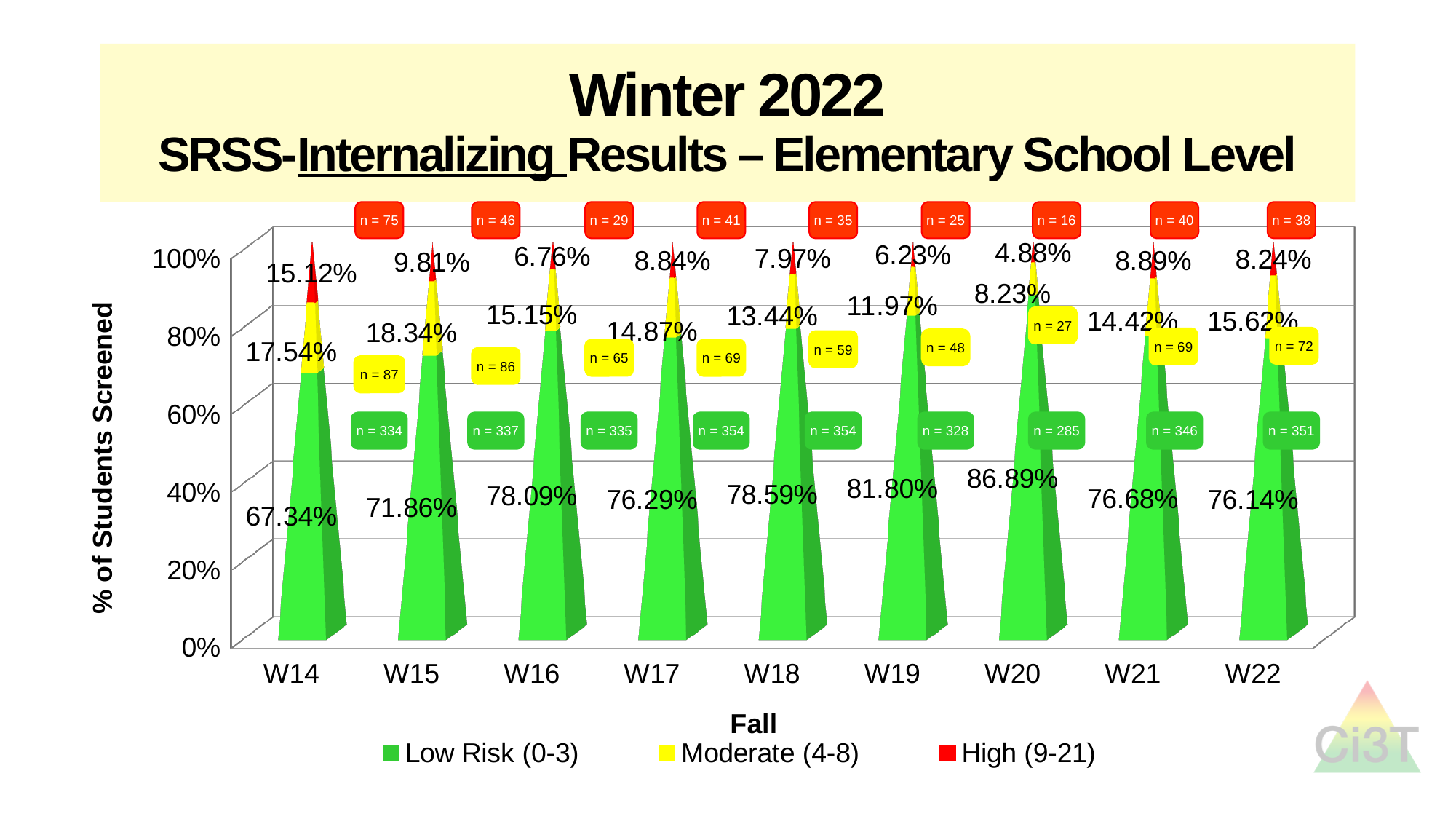
How many series does the legend list? 3 What is the High (9-21) percentage for W20? 4.88% What is the Moderate (4-8) percentage for W22? 15.62% What is the label of the y axis? % of Students Screened What is the difference between the Low Risk (0-3) percentages for W20 and W14? 19.55% Which category has the highest Low Risk (0-3) percentage? W20 Which is larger, the Moderate (4-8) percentage for W15 or for W19? W15 What percentage of students screened were Low Risk (0-3) in W14? 67.34% What kind of chart is shown on the slide? Bar chart Which category has the highest High (9-21) percentage? W14 How many categories are shown on the x axis? 9 Which category has the lowest Low Risk (0-3) percentage? W14